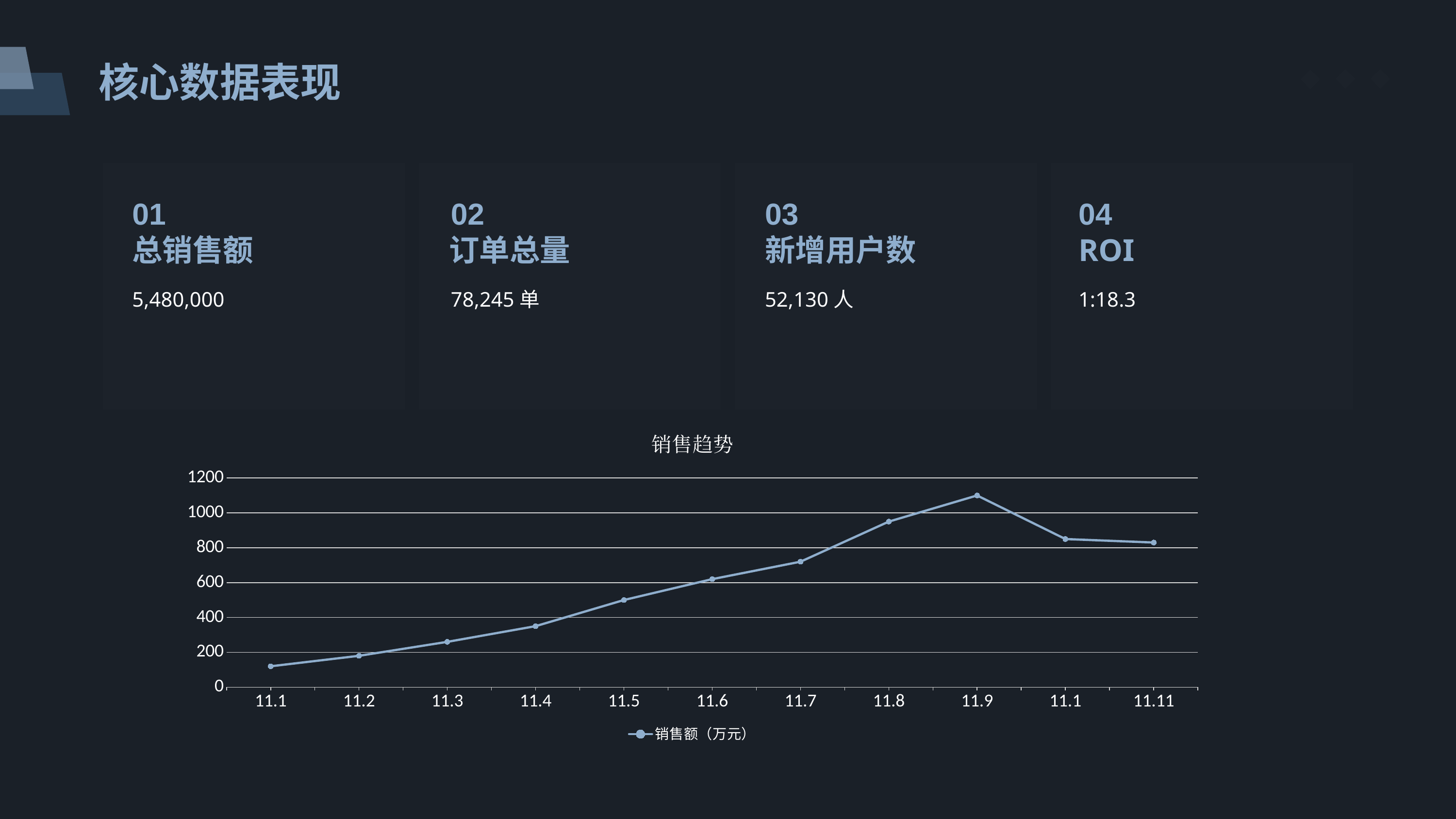
How many data points are plotted on the line in the chart? 11 What series does the chart's legend list? 销售额（万元） Which has the larger sales value, 11.9 or 11.11? 11.9 Is the value for 11.8 greater or less than 1000? less Does the sales value rise or fall from the first point on the x axis to 11.9? rise What kind of chart is shown on the slide? line chart Is the value for 11.7 greater or less than 600? greater Is the value for 11.4 greater or less than 400? less What is the title of the chart on the slide? 销售趋势 How many series does the chart's legend list? 1 Which date on the x axis has the highest sales value in the chart? 11.9